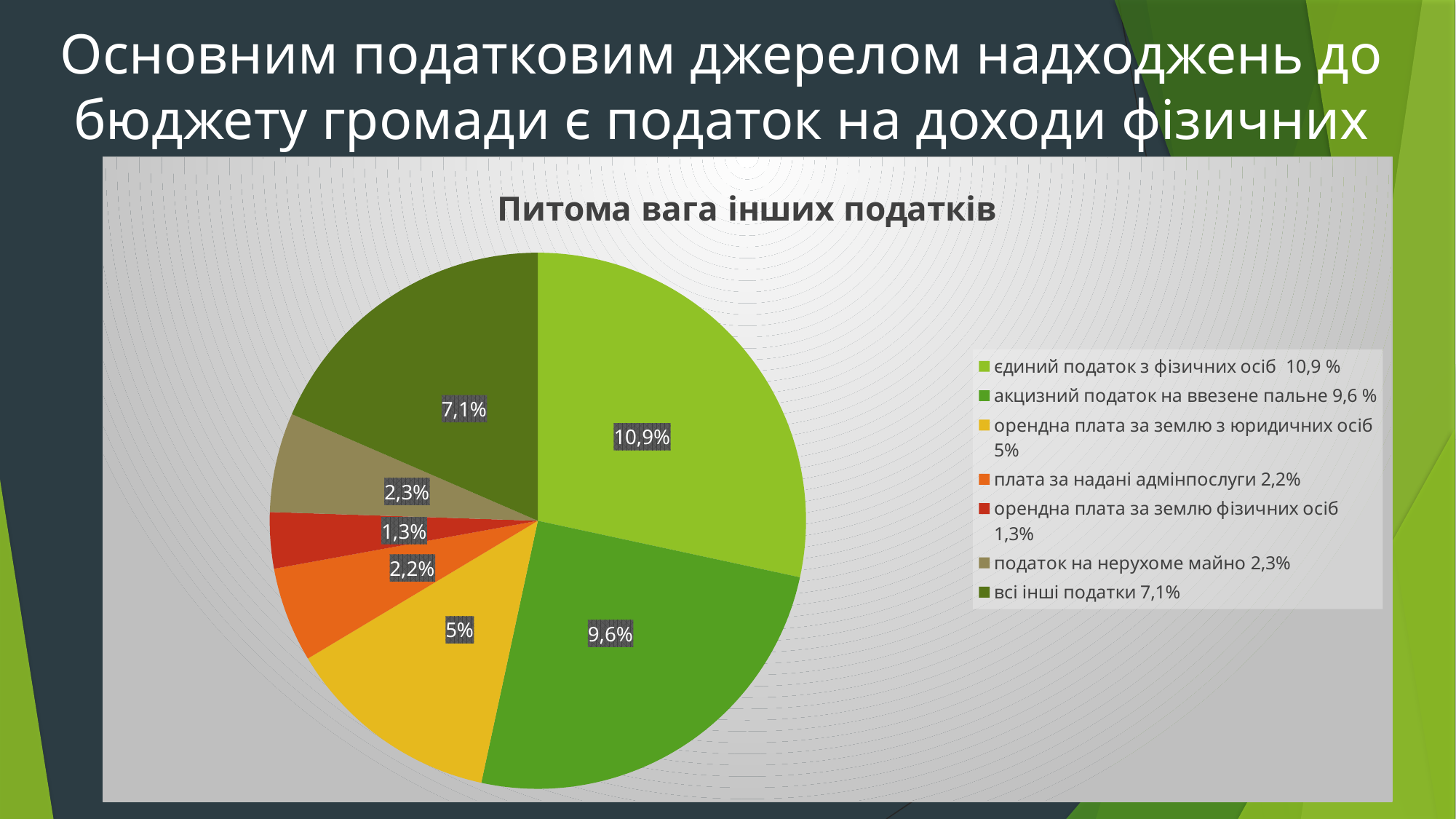
How many slices does the pie chart have? 7 What is the title of the chart? Питома вага інших податків What value is shown for "всі інші податки"? 7,1% Which category has the largest slice of the pie? єдиний податок з фізичних осіб What value is shown for "єдиний податок з фізичних осіб"? 10,9% What value is shown for "орендна плата за землю з юридичних осіб"? 5% What value is shown for "акцизний податок на ввезене пальне"? 9,6% What is the difference between the values for "єдиний податок з фізичних осіб" and "акцизний податок на ввезене пальне"? 1,3% What value is shown for "плата за надані адмінпослуги"? 2,2% Which is larger: the value for "податок на нерухоме майно" or the value for "плата за надані адмінпослуги"? податок на нерухоме майно What kind of chart is shown on the slide? pie chart Which category has the smallest slice of the pie? орендна плата за землю фізичних осіб